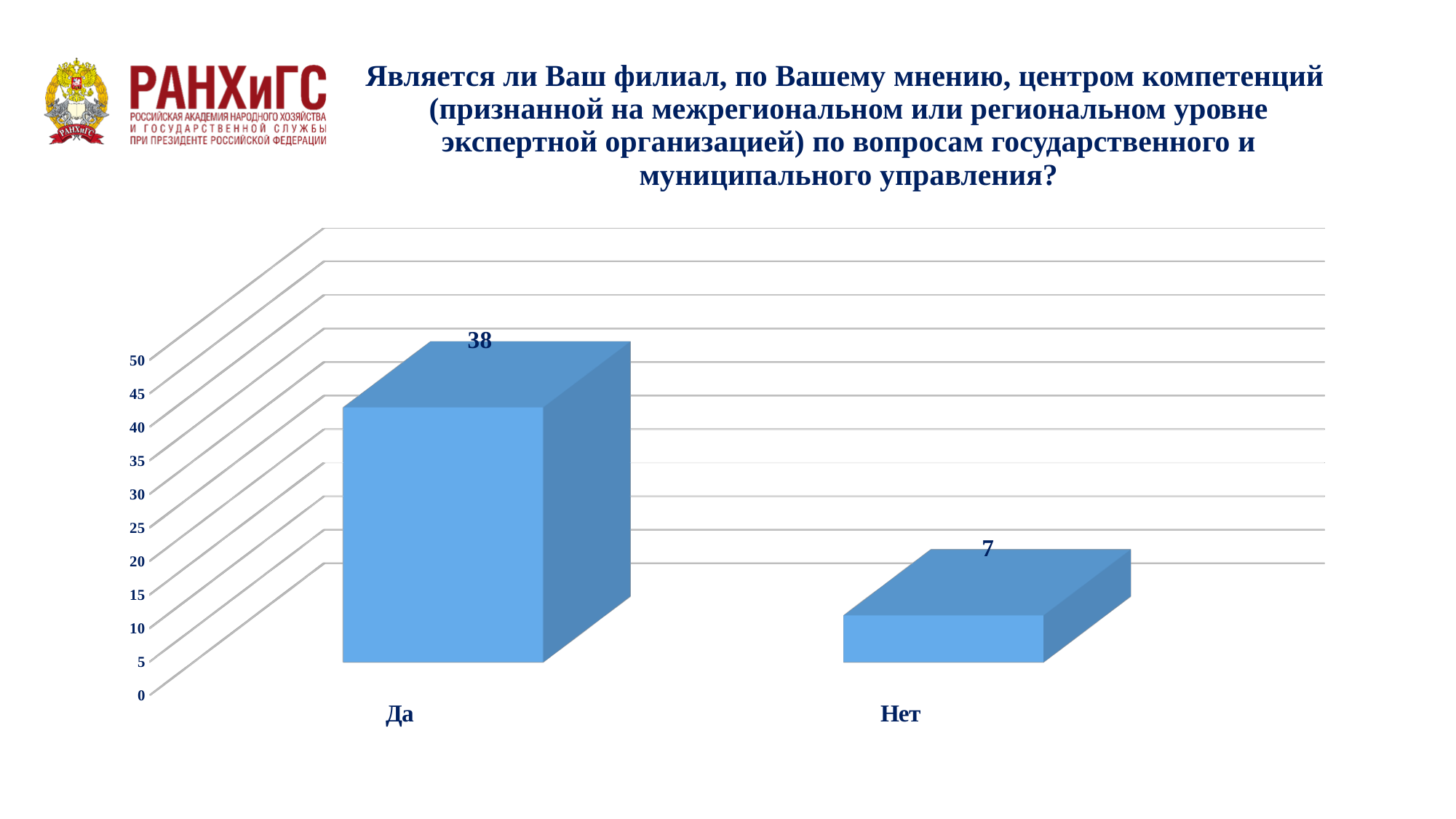
What kind of chart is shown on the slide? bar chart Which category has the highest value? Да What is the maximum value shown on the vertical axis? 50 What is the total of the two values shown in the chart? 45 Which is larger, the value for "Да" or the value for "Нет"? Да Is the value for "Нет" greater or less than 10? less Is the value for "Да" greater or less than 30? greater How many categories are shown on the x axis? 2 What is the value for "Нет"? 7 Which category has the lowest value? Нет What is the value for "Да"? 38 What is the difference between the values for "Да" and "Нет"? 31